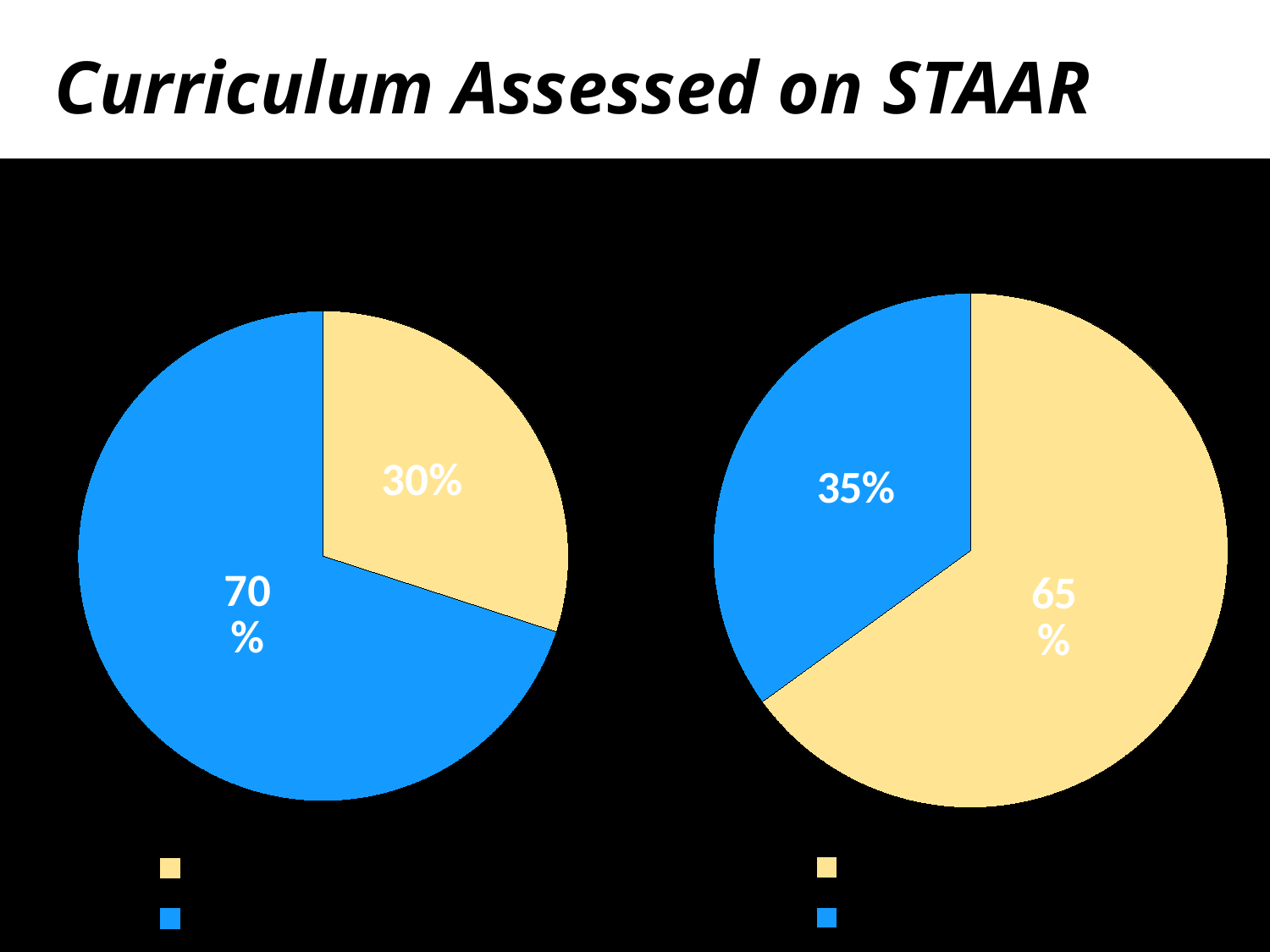
How many slices does the right pie chart have? 2 In the right pie chart, what percentage does the yellow slice show? 65% In the left pie chart, what is the difference between the blue slice and the yellow slice? 40% In the left pie chart, which colour slice is the largest? Blue In the right pie chart, which colour slice is the smallest? Blue What type of chart is shown on the left of the slide? Pie chart What is the title of the slide? Curriculum Assessed on STAAR In the right pie chart, what is the difference between the yellow slice and the blue slice? 30% In the right pie chart, what percentage does the blue slice show? 35% In the left pie chart, what percentage does the blue slice show? 70% In the left pie chart, what percentage does the yellow slice show? 30% Is the blue slice larger in the left pie chart or the right pie chart? Left pie chart